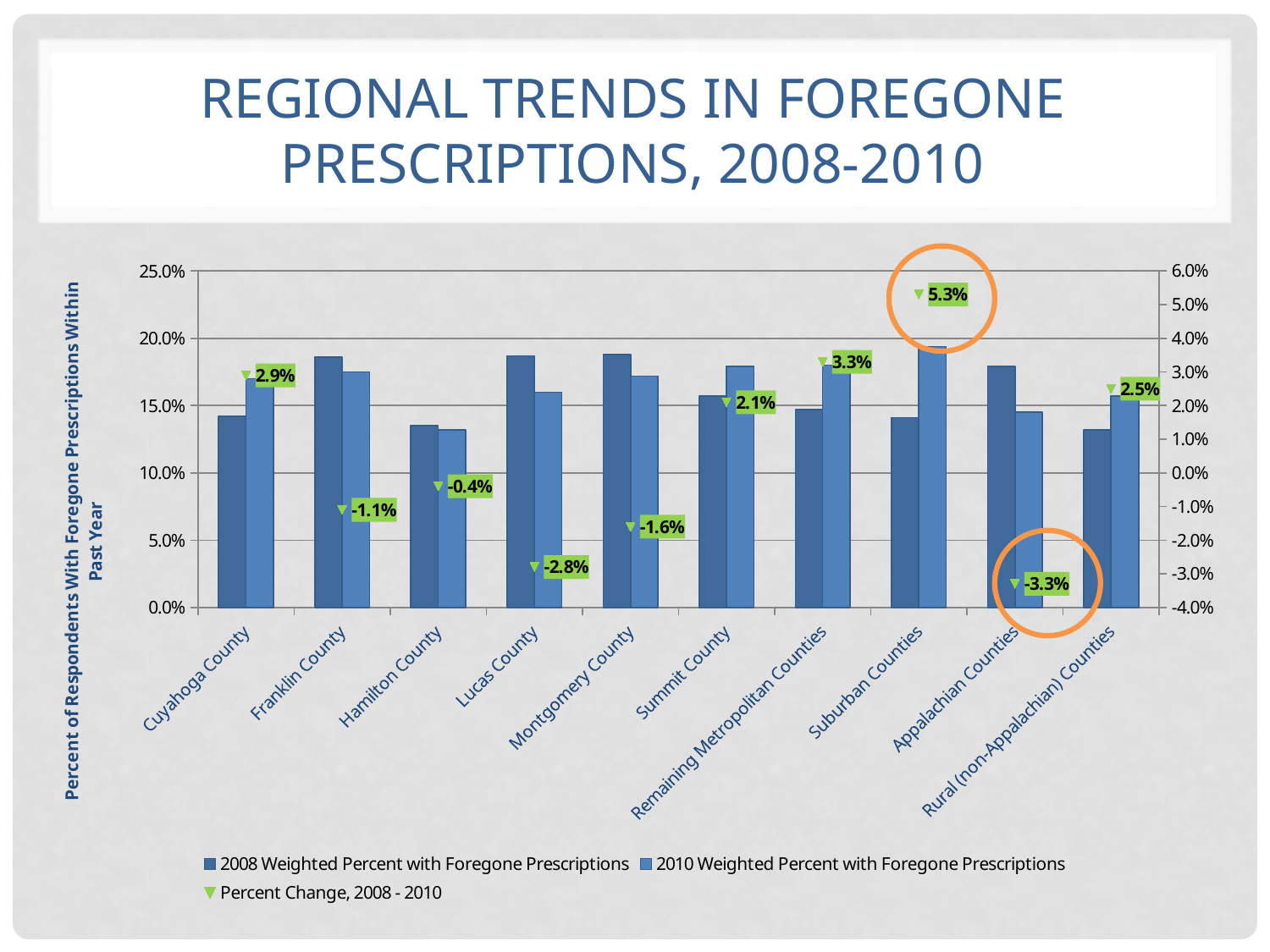
Is the 2010 Weighted Percent with Foregone Prescriptions for Hamilton County greater or less than 15.0%? less How many series does the legend list? 3 Which category has the lowest Percent Change, 2008 - 2010? Appalachian Counties What is the difference between the Percent Change for Cuyahoga County and Summit County? 0.8% Is the 2008 Weighted Percent with Foregone Prescriptions for Franklin County greater or less than 15.0%? greater How many regional categories are shown on the x axis? 10 What is the Percent Change, 2008 - 2010 for Suburban Counties? 5.3% What is the Percent Change, 2008 - 2010 for Lucas County? -2.8% Which category has the highest Percent Change, 2008 - 2010? Suburban Counties What is the Percent Change, 2008 - 2010 for Hamilton County? -0.4% Which has a larger Percent Change, 2008 - 2010: Remaining Metropolitan Counties or Rural (non-Appalachian) Counties? Remaining Metropolitan Counties What is the title of the slide? Regional Trends in Foregone Prescriptions, 2008-2010